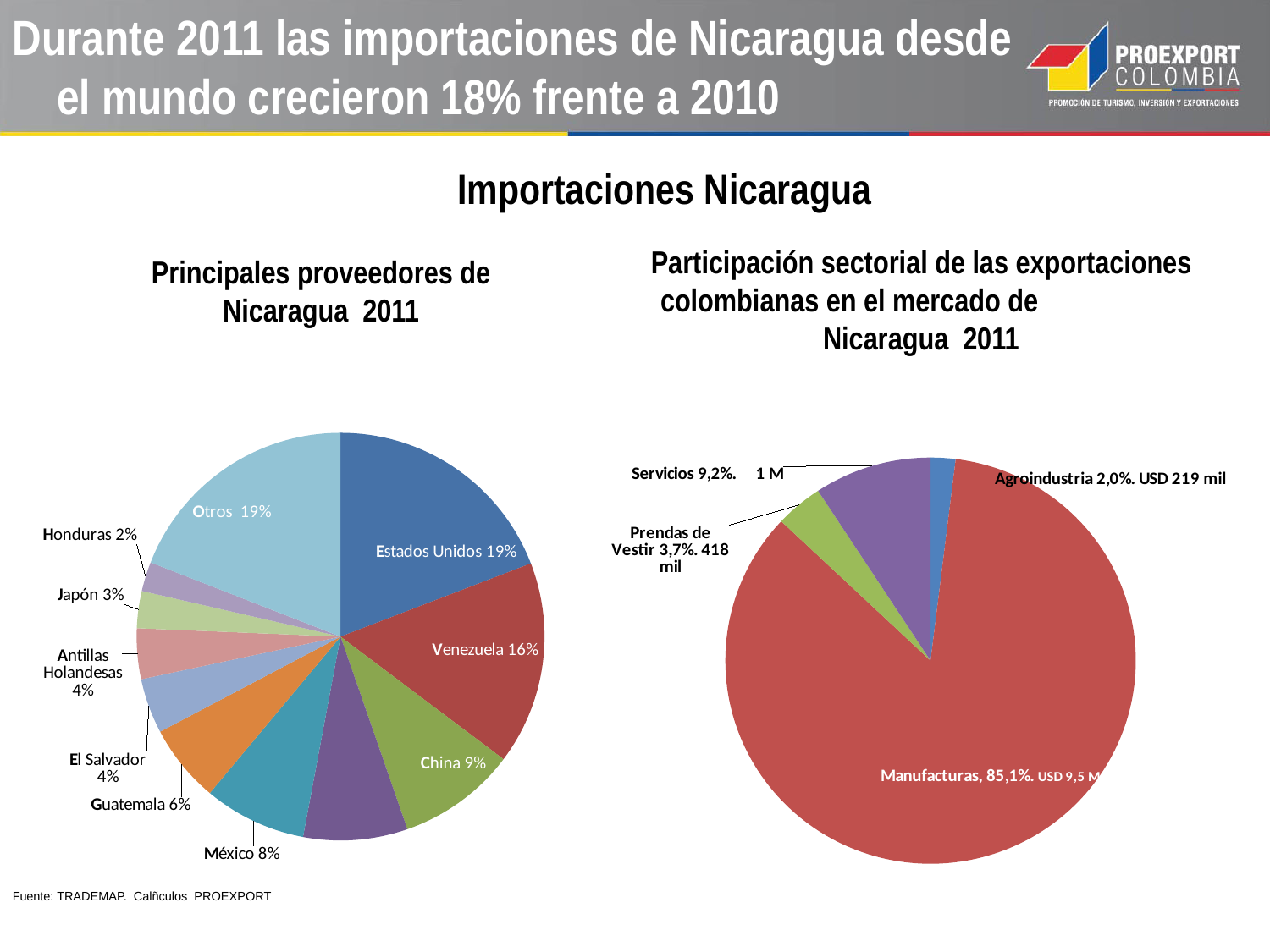
In the left pie chart (Principales proveedores de Nicaragua 2011), which is larger, the share of China or the share of México? China In the left pie chart (Principales proveedores de Nicaragua 2011), what share does Venezuela have? 16% How many sectors are shown in the right pie chart (Participación sectorial de las exportaciones colombianas en el mercado de Nicaragua 2011)? 4 In the right pie chart (Participación sectorial de las exportaciones colombianas en el mercado de Nicaragua 2011), what share does Manufacturas have? 85,1% In the left pie chart (Principales proveedores de Nicaragua 2011), what is the difference in percentage points between Estados Unidos and Venezuela? 3 percentage points In the left pie chart (Principales proveedores de Nicaragua 2011), what share does China have? 9% In the left pie chart (Principales proveedores de Nicaragua 2011), what share does Guatemala have? 6% In the left pie chart (Principales proveedores de Nicaragua 2011), what share does Japón have? 3% In the right pie chart (Participación sectorial de las exportaciones colombianas en el mercado de Nicaragua 2011), which sector has the smallest share? Agroindustria In the right pie chart (Participación sectorial de las exportaciones colombianas en el mercado de Nicaragua 2011), what share does Servicios have? 9,2% What kind of chart is used for the Principales proveedores de Nicaragua 2011 chart? Pie chart In the left pie chart (Principales proveedores de Nicaragua 2011), which labelled country has the smallest share? Honduras